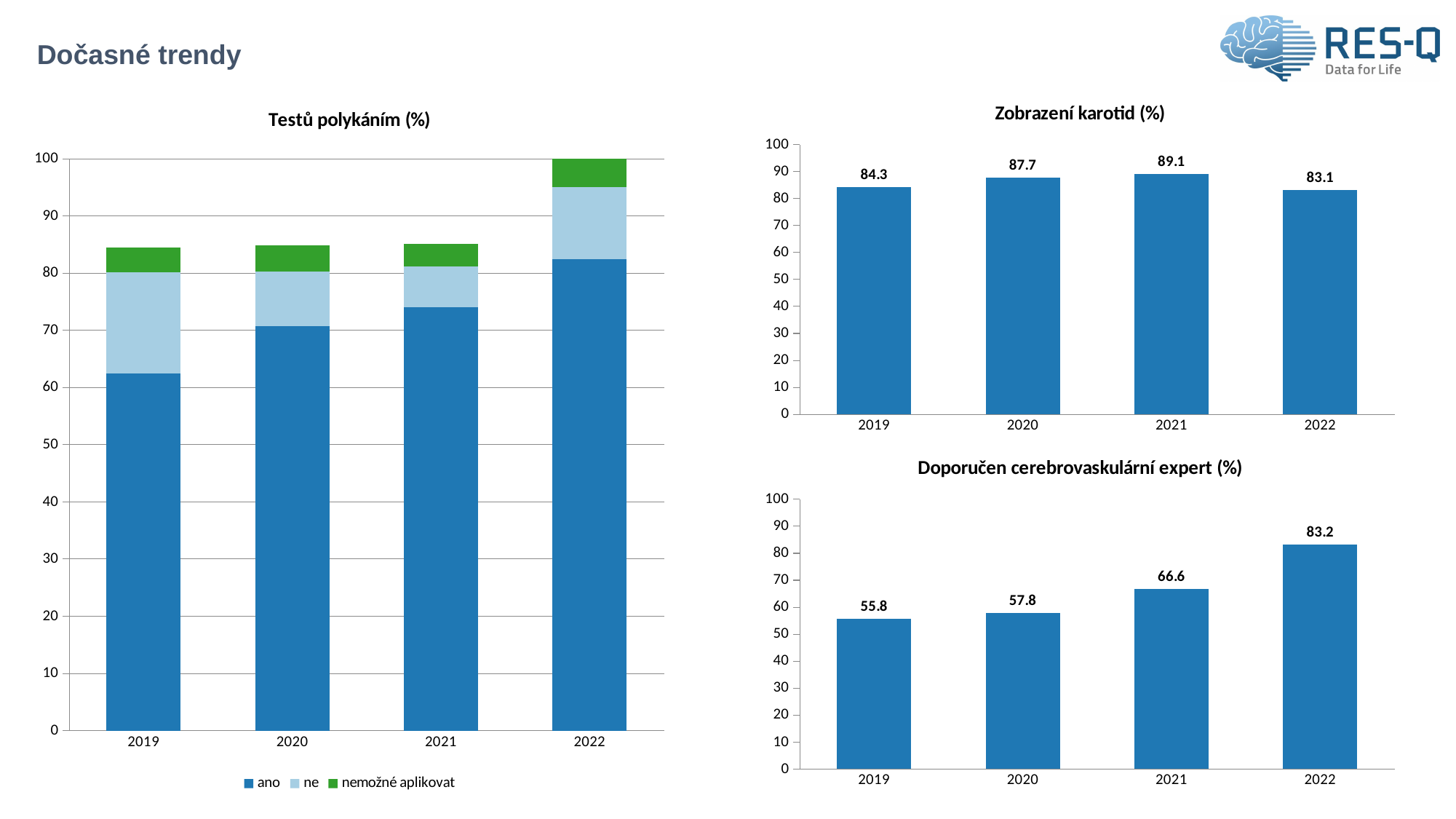
In the chart titled "Testů polykáním (%)", which year has the tallest stacked bar? 2022 In the chart titled "Zobrazení karotid (%)", which year has the lowest value? 2022 What kind of chart is the one titled "Testů polykáním (%)"? stacked bar chart In the chart titled "Zobrazení karotid (%)", what is the difference between the values for 2021 and 2022? 6 In the chart titled "Zobrazení karotid (%)", what is the value for 2021? 89.1 In the chart titled "Doporučen cerebrovaskulární expert (%)", what is the difference between the values for 2022 and 2021? 16.6 In the chart titled "Testů polykáním (%)", is the "ano" value for 2019 greater or less than 70? less In the chart titled "Doporučen cerebrovaskulární expert (%)", do the values rise or fall from 2019 to 2022? rise In the chart titled "Doporučen cerebrovaskulární expert (%)", what is the value for 2019? 55.8 In the chart titled "Testů polykáním (%)", is the "ano" value for 2022 greater or less than 80? greater In the chart titled "Doporučen cerebrovaskulární expert (%)", which year has the highest value? 2022 In the chart titled "Testů polykáním (%)", how many series does the legend list? 3